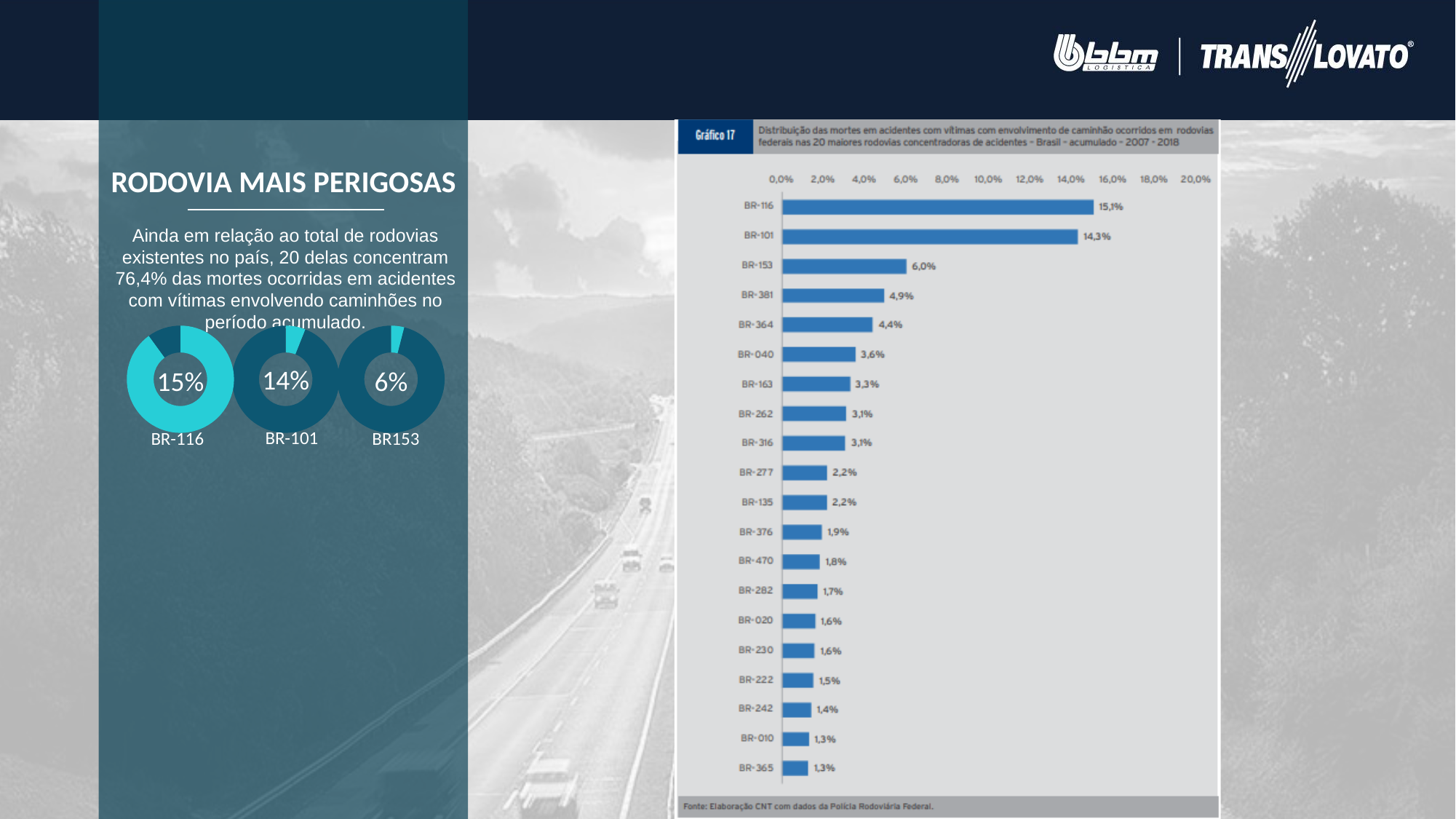
In the bar chart Gráfico 17, what is the value for BR-040? 3,6% In the bar chart Gráfico 17, what is the difference between the values for BR-116 and BR-101? 0,8 percentage points In the bar chart Gráfico 17, is the value for BR-101 greater or less than 12,0%? greater In the bar chart Gráfico 17, which is larger, the value for BR-153 or the value for BR-364? BR-153 In the bar chart Gráfico 17, what is the value for BR-381? 4,9% What kind of chart is Gráfico 17 on the right of the slide? Bar chart How many highways are listed in the bar chart Gráfico 17? 20 How many donut charts are shown on the left side of the slide? 3 In the donut chart labelled BR-101 on the left of the slide, what percentage is shown? 14% In the bar chart Gráfico 17, which highway has the highest share of deaths? BR-116 In the bar chart Gráfico 17, what is the value for BR-365? 1,3% In the bar chart Gráfico 17, do the values rise or fall going down the list from BR-116 to BR-365? Fall